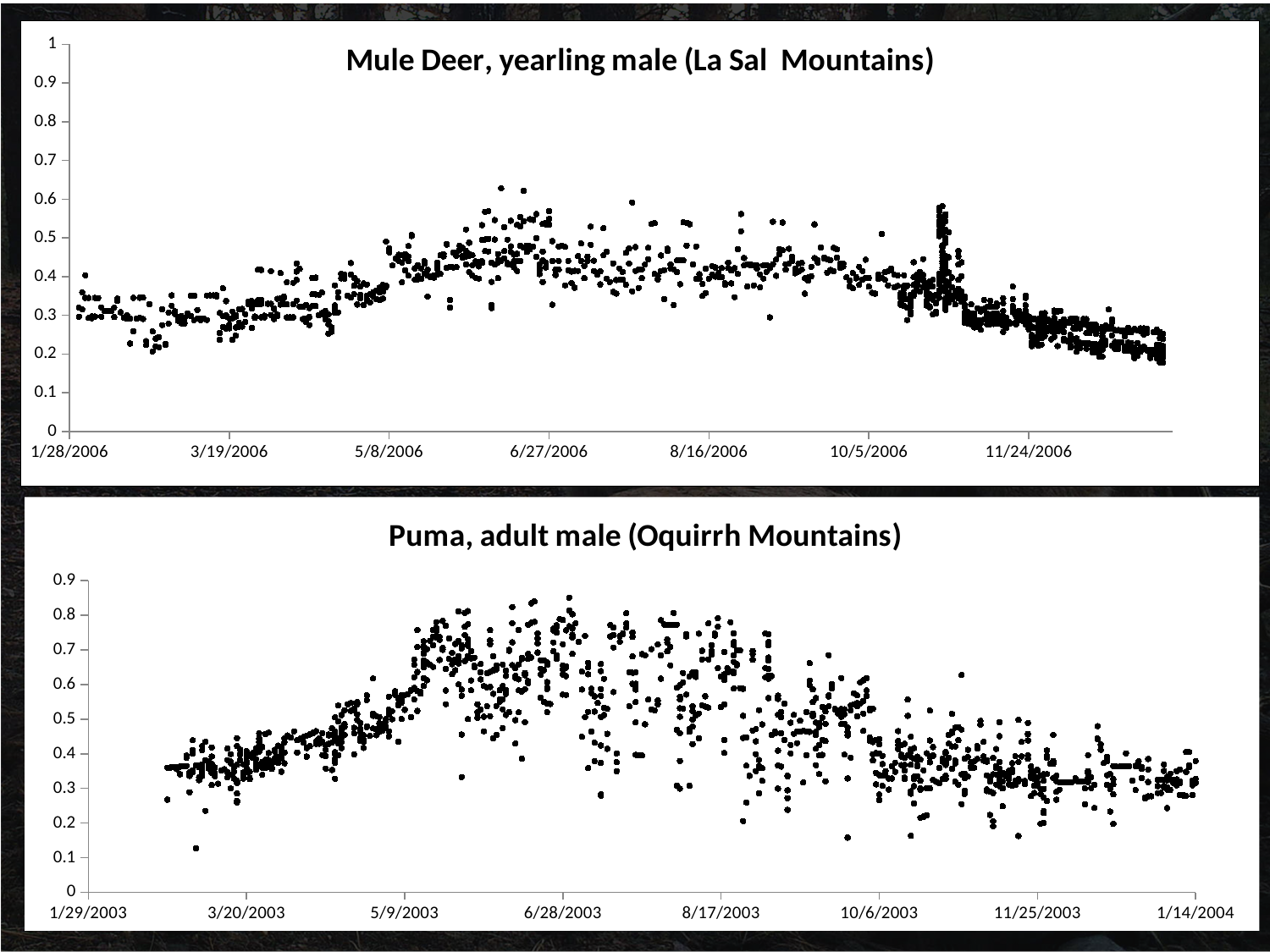
In the top chart (Mule Deer), are the values plotted at the far right end of the series (after 11/24/2006) greater or less than 0.3? less In the bottom chart (Puma), are the values plotted around 3/20/2003 greater or less than 0.5? less In the bottom chart (Puma), do the values rise or fall between 3/20/2003 and 5/9/2003? rise In the top chart (Mule Deer), do the values rise or fall from 10/5/2006 to the end of the series? fall In the top chart (Mule Deer), are the values plotted around 6/27/2006 greater or less than 0.3? greater What is the title of the bottom chart on the slide? Puma, adult male (Oquirrh Mountains) What is the title of the top chart on the slide? Mule Deer, yearling male (La Sal Mountains) How many charts are shown on the slide? 2 In the top chart (Mule Deer), are the values higher around 6/27/2006 or around 3/19/2006? around 6/27/2006 In the bottom chart (Puma), do the values rise or fall between 8/17/2003 and 11/25/2003? fall What kind of chart is the top chart, 'Mule Deer, yearling male (La Sal Mountains)'? scatter chart